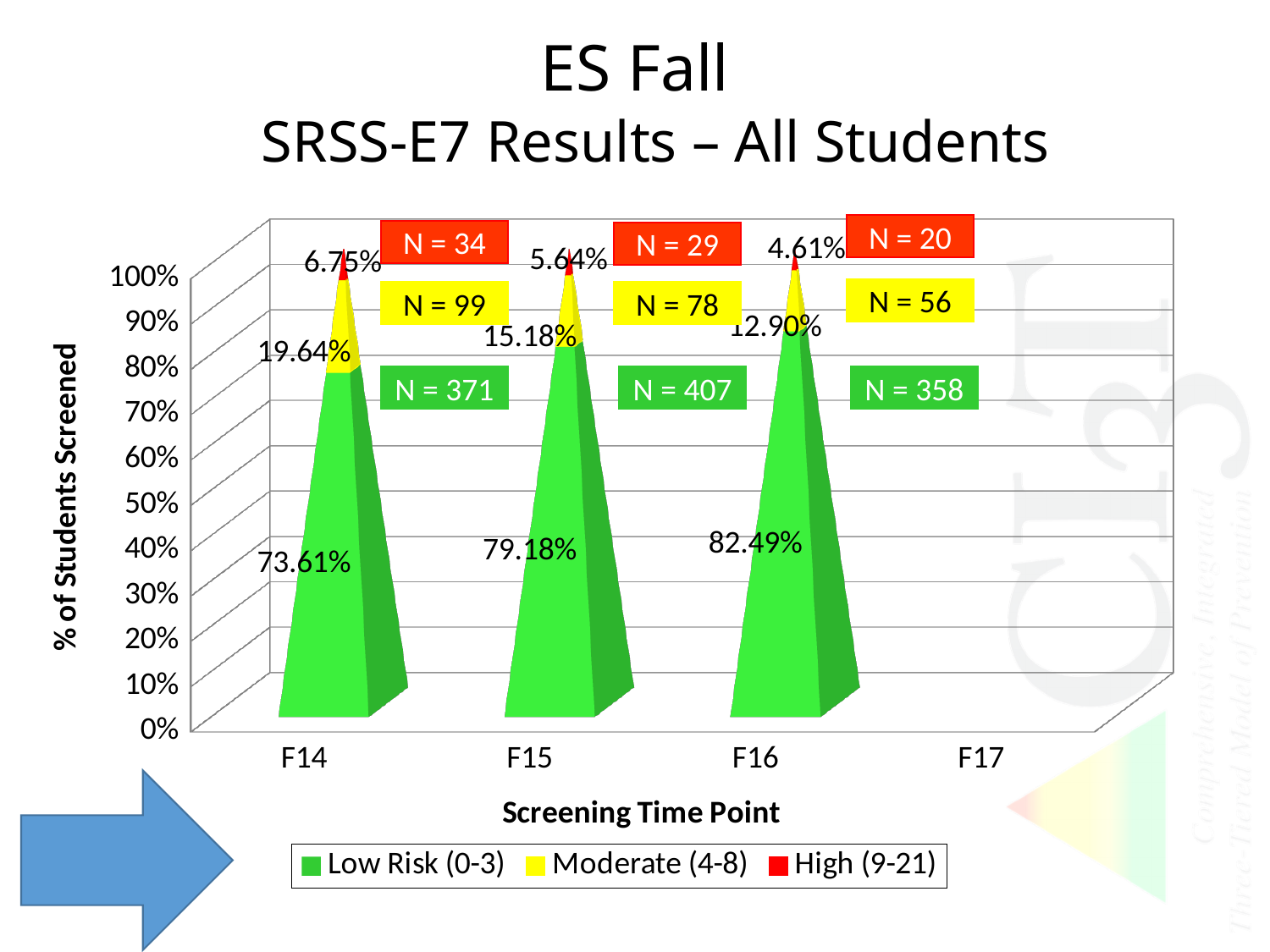
What is the Low Risk (0-3) percentage at F14? 73.61% How many screening time points have data plotted on the chart? 3 Does the Low Risk (0-3) percentage rise or fall from F14 to F16? rise What is the High (9-21) percentage at F16? 4.61% What is the N value shown for the Low Risk group at F15? N = 407 Is the Moderate (4-8) percentage larger at F14 or at F16? F14 How many series does the legend list? 3 Which screening time point has the highest Low Risk (0-3) percentage? F16 What is the N value shown for the High group at F14? N = 34 Which screening time point has the lowest High (9-21) percentage? F16 What is the difference between the Low Risk percentage at F16 and at F14? 8.88 percentage points What is the Moderate (4-8) percentage at F15? 15.18%